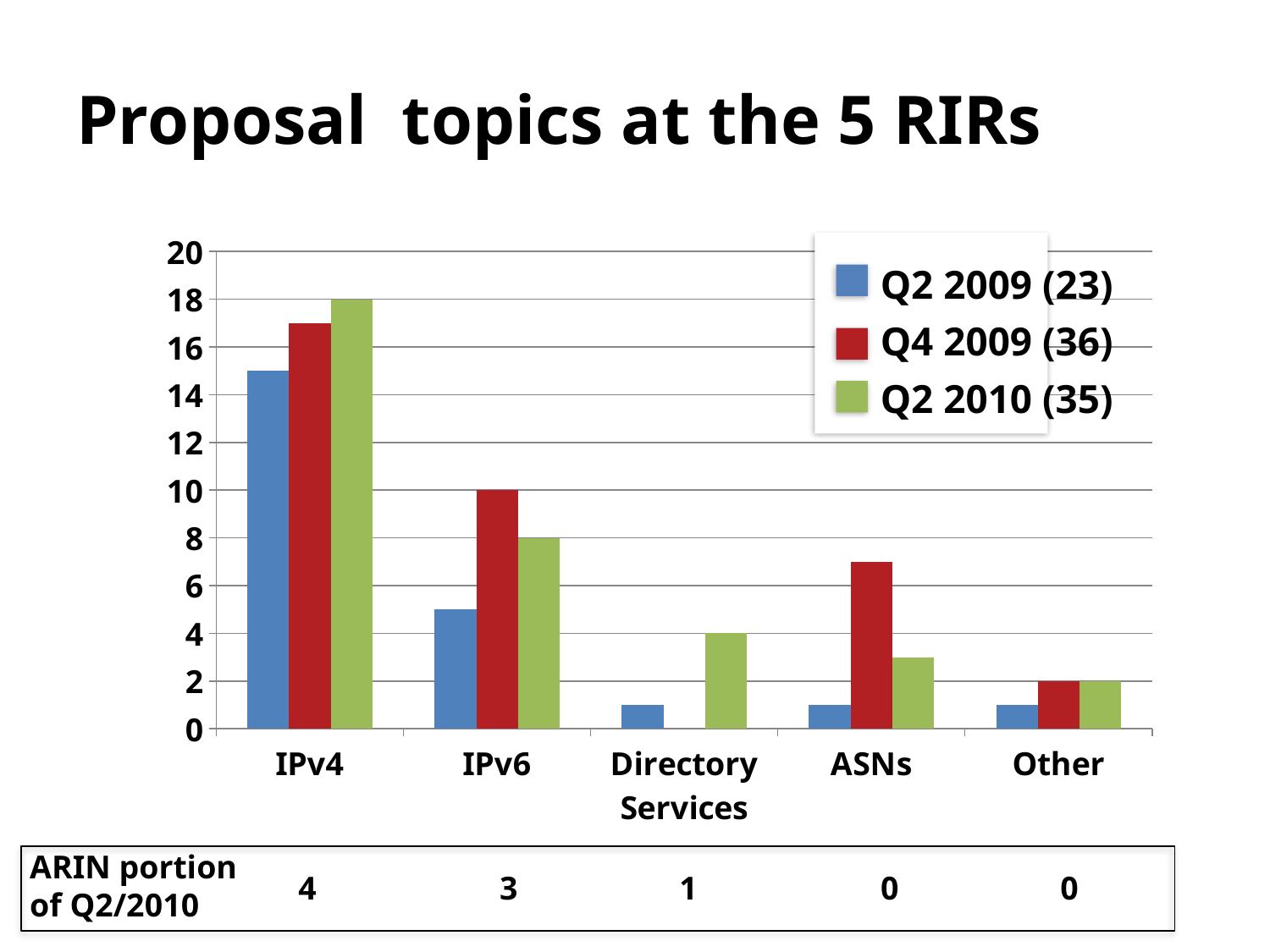
How many topic categories are shown on the x axis? 5 How many series does the legend list? 3 What is the value for Directory Services in the Q2 2010 (35) series? 4 What is the value for Other in the Q4 2009 (36) series? 2 Which topic has the lowest value in the Q4 2009 (36) series? Directory Services What is the value for IPv6 in the Q4 2009 (36) series? 10 Which topic has the highest value in the Q4 2009 (36) series? IPv4 Is the value for ASNs in the Q4 2009 (36) series greater or less than 6? greater What is the value for IPv4 in the Q2 2010 (35) series? 18 What kind of chart is shown on the slide? bar chart Which is larger for IPv6: the Q4 2009 (36) value or the Q2 2010 (35) value? Q4 2009 (36) What is the difference between the Q4 2009 (36) and Q2 2010 (35) values for IPv6? 2